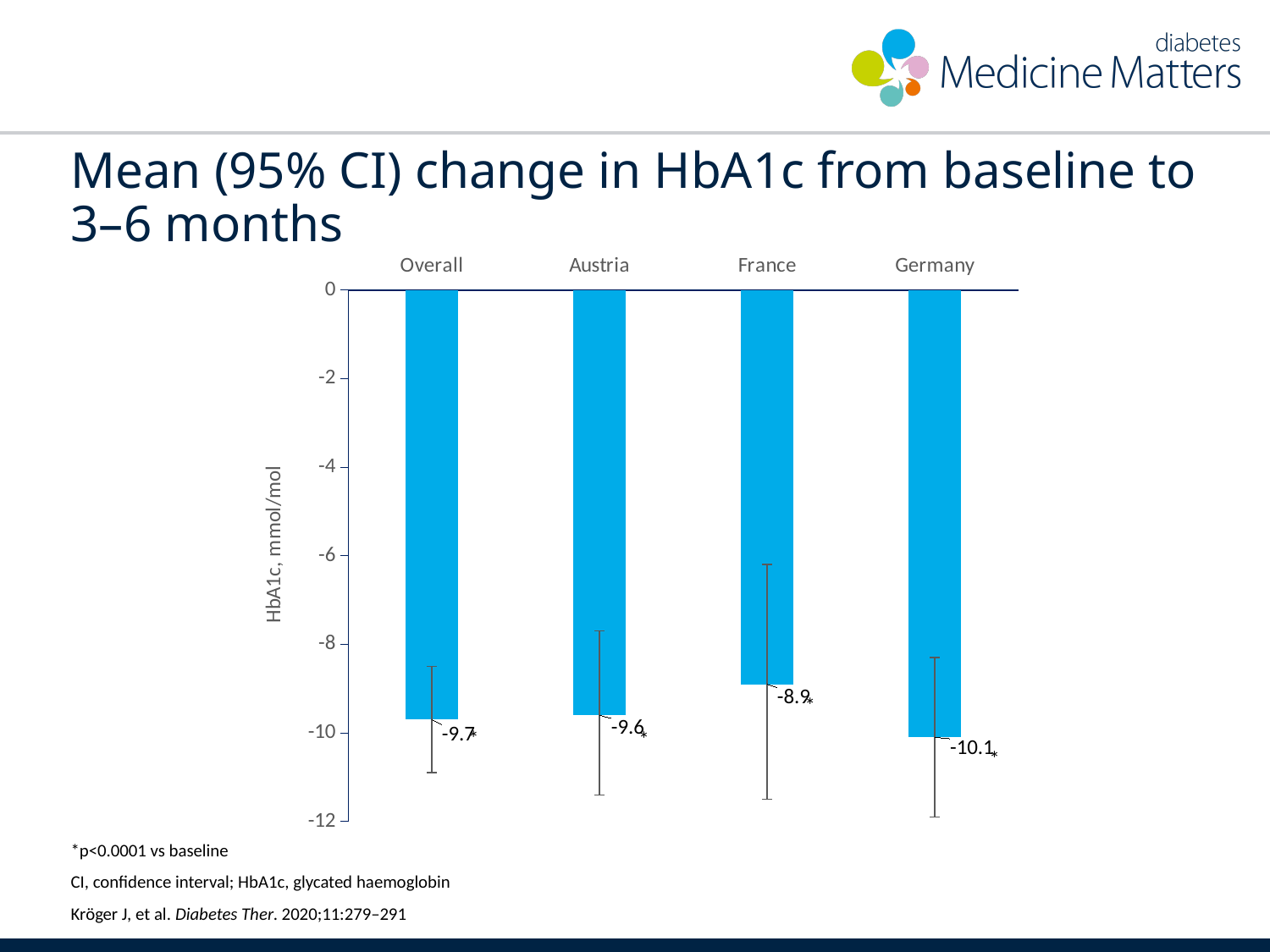
What is the mean change in HbA1c for France? -8.9 Which category shows the largest reduction in HbA1c (the most negative value)? Germany Which has a larger reduction in HbA1c, Germany or France? Germany Which category shows the smallest reduction in HbA1c (the least negative value)? France What is the mean change in HbA1c for Germany? -10.1 What is the difference between the HbA1c change for Overall and for Austria? 0.1 How many categories are shown on the chart? 4 What kind of chart is shown on the slide? Bar chart What is the label of the vertical axis? HbA1c, mmol/mol What is the mean change in HbA1c for the Overall group? -9.7 What is the mean change in HbA1c for Austria? -9.6 What is the difference between the HbA1c change for Germany and for France? 1.2